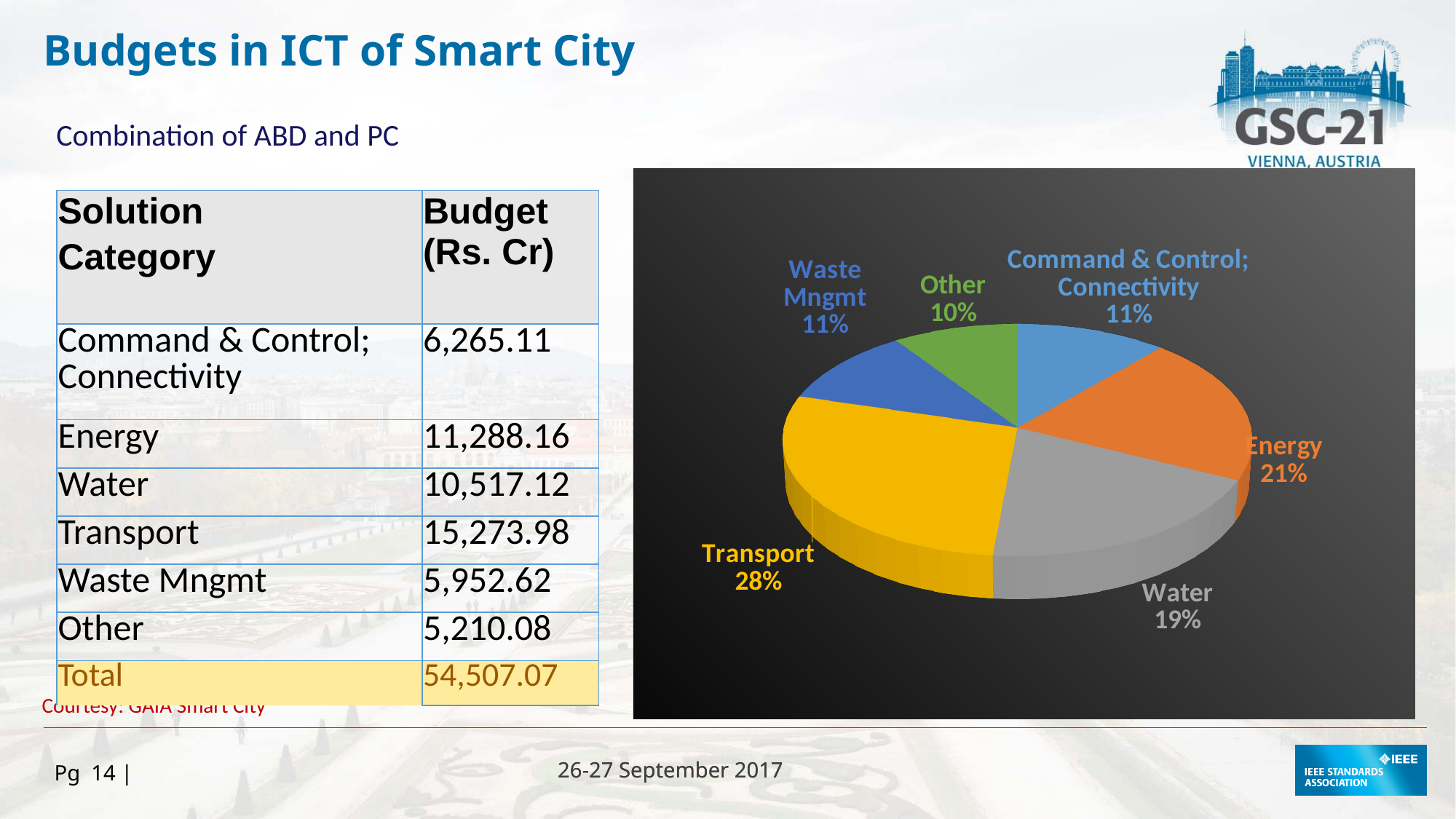
What kind of chart is shown on the slide? pie chart What percentage is shown for Waste Mngmt in the pie chart? 11% Which slice is larger in the pie chart, Energy or Water? Energy What share of the pie does Transport account for? 28% Which category has the largest slice of the pie chart? Transport Which category has the smallest slice of the pie chart? Other How many slices does the pie chart have? 6 What colour is the Transport slice in the pie chart? yellow What percentage is shown for Energy in the pie chart? 21% What percentage is shown for Other in the pie chart? 10% What percentage is shown for Water in the pie chart? 19% What is the difference in percentage points between the Transport slice and the Water slice? 9